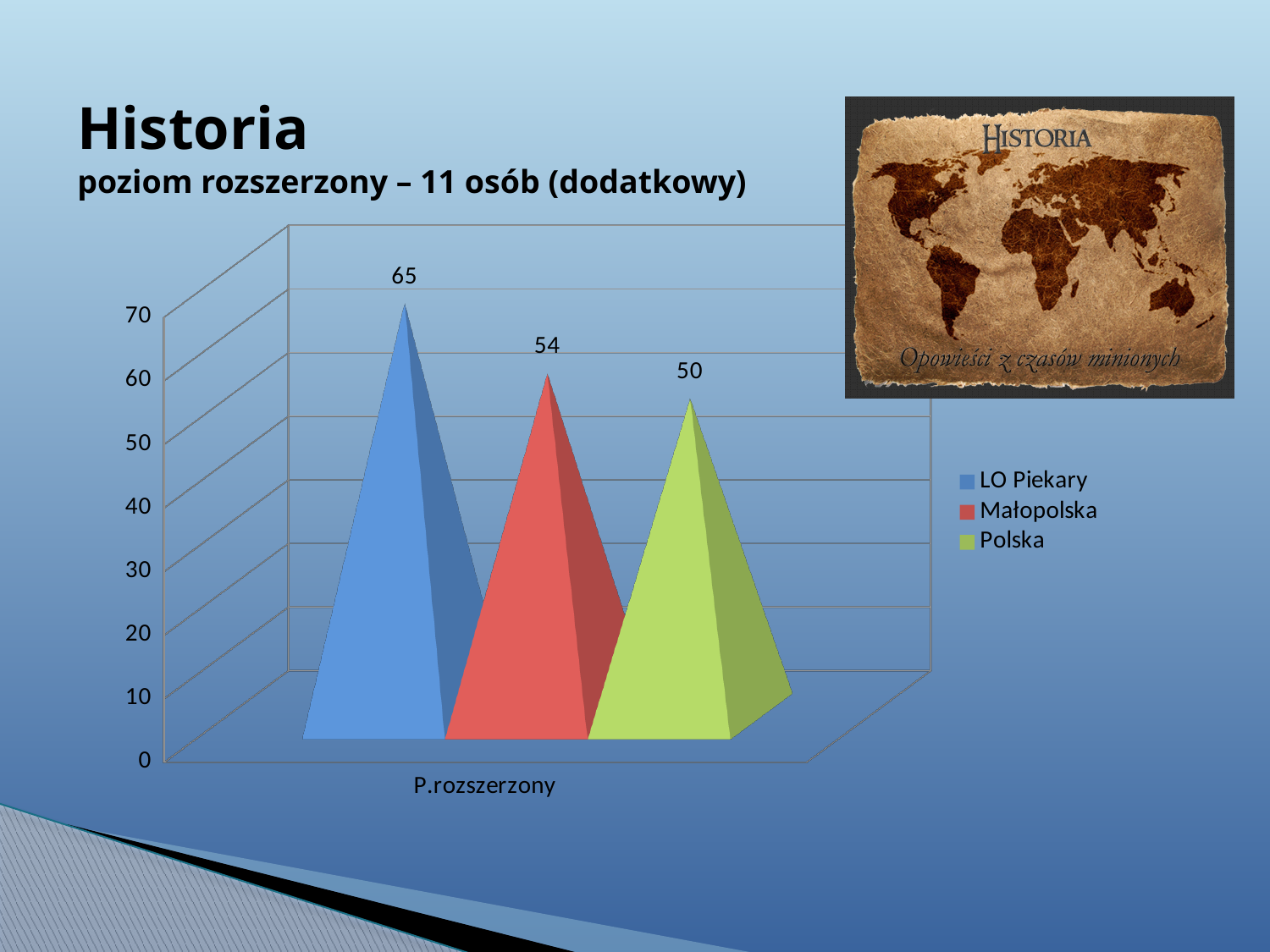
What is the value for Małopolska? 54 Is the value for Małopolska greater or less than 60? less What kind of chart is shown on the slide? bar chart How many series does the legend list? 3 What is the difference between the values for Małopolska and Polska? 4 What is the difference between the values for LO Piekary and Polska? 15 What is the value for Polska? 50 Which is larger, the value for LO Piekary or the value for Małopolska? LO Piekary Which series has the highest value? LO Piekary Which series has the lowest value? Polska What is the label on the x axis category? P.rozszerzony What is the value for LO Piekary? 65